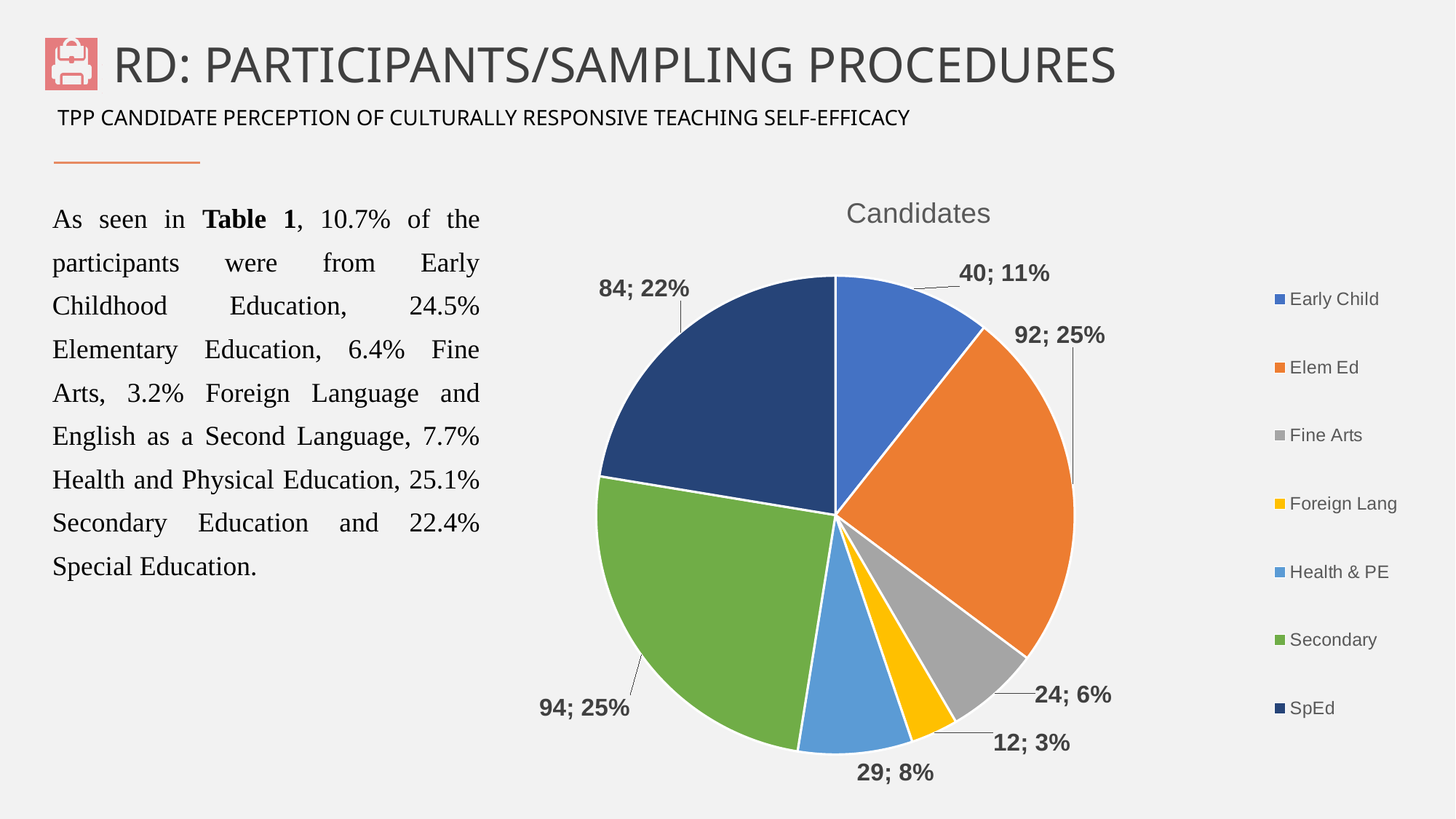
What percentage share does the Fine Arts slice have? 6% What is the title of the chart? Candidates How many candidates are in the Early Child slice? 40 Which has more candidates, SpEd or Early Child? SpEd How many categories does the pie chart have? 7 What percentage share does the SpEd slice have? 22% Which category has the largest number of candidates? Secondary What is the difference in candidates between Elem Ed and Fine Arts? 68 What type of chart is shown on the slide? pie chart Which category has the smallest number of candidates? Foreign Lang How many candidates are in the Health & PE slice? 29 What colour is the Secondary slice in the pie chart? green